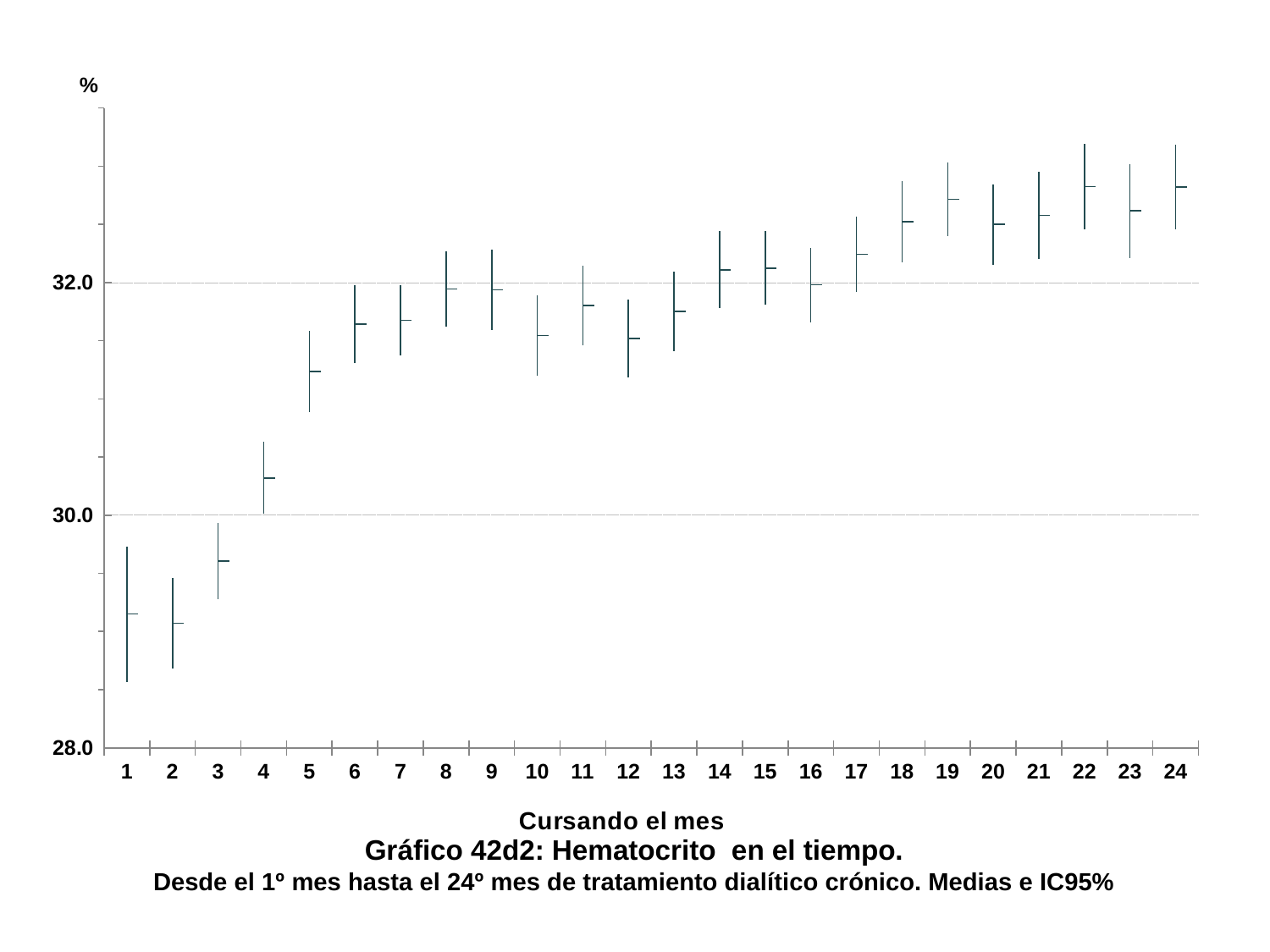
What is the title of the chart? Gráfico 42d2: Hematocrito en el tiempo. Which has the larger mean value, month 1 or month 24? month 24 What is the label of the x axis? Cursando el mes Is the mean value for month 5 greater or less than 32.0? less Is the mean value for month 4 greater or less than 30.0? greater Is the mean value for month 24 greater or less than 32.0? greater Overall, do the mean values rise or fall from month 1 to month 24? rise Which has the larger mean value, month 4 or month 5? month 5 How many months (points) are plotted along the x axis? 24